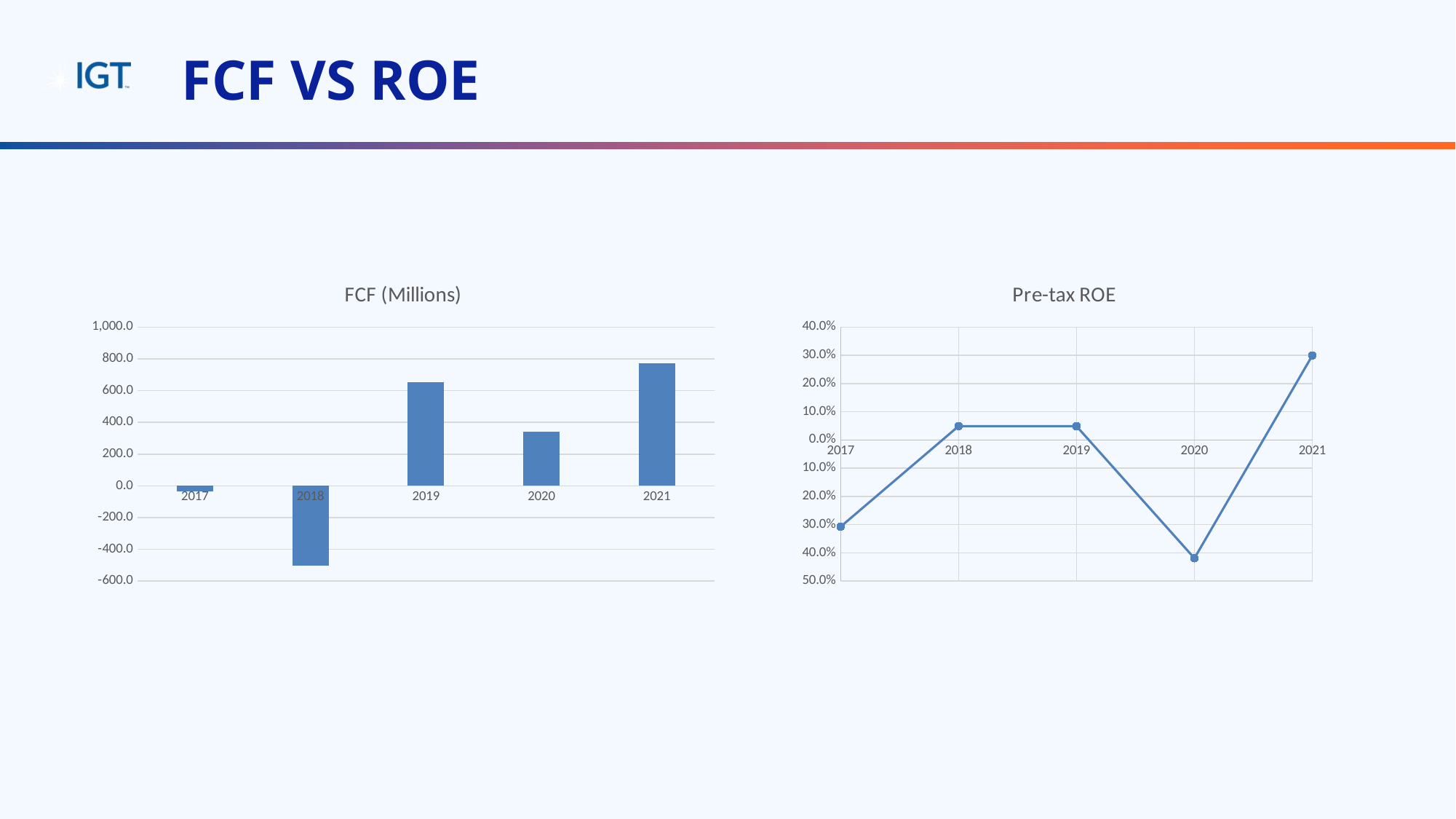
In the FCF (Millions) chart, how many years are shown on the x axis? 5 What kind of chart is the Pre-tax ROE chart on the right? line chart In the Pre-tax ROE chart, which year has the highest pre-tax ROE? 2021 In the FCF (Millions) chart, is the value for 2021 greater or less than 600.0? greater In the FCF (Millions) chart, which year has the highest FCF? 2021 In the FCF (Millions) chart, which year has the larger FCF, 2019 or 2020? 2019 In the FCF (Millions) chart, is the value for 2018 greater or less than -400.0? less In the FCF (Millions) chart, which year has the lowest FCF? 2018 In the Pre-tax ROE chart, which year has the lowest pre-tax ROE? 2020 In the Pre-tax ROE chart, does the value rise or fall from 2019 to 2020? fall What kind of chart is the FCF (Millions) chart on the left? bar chart In the FCF (Millions) chart, is the value for 2020 greater or less than 400.0? less